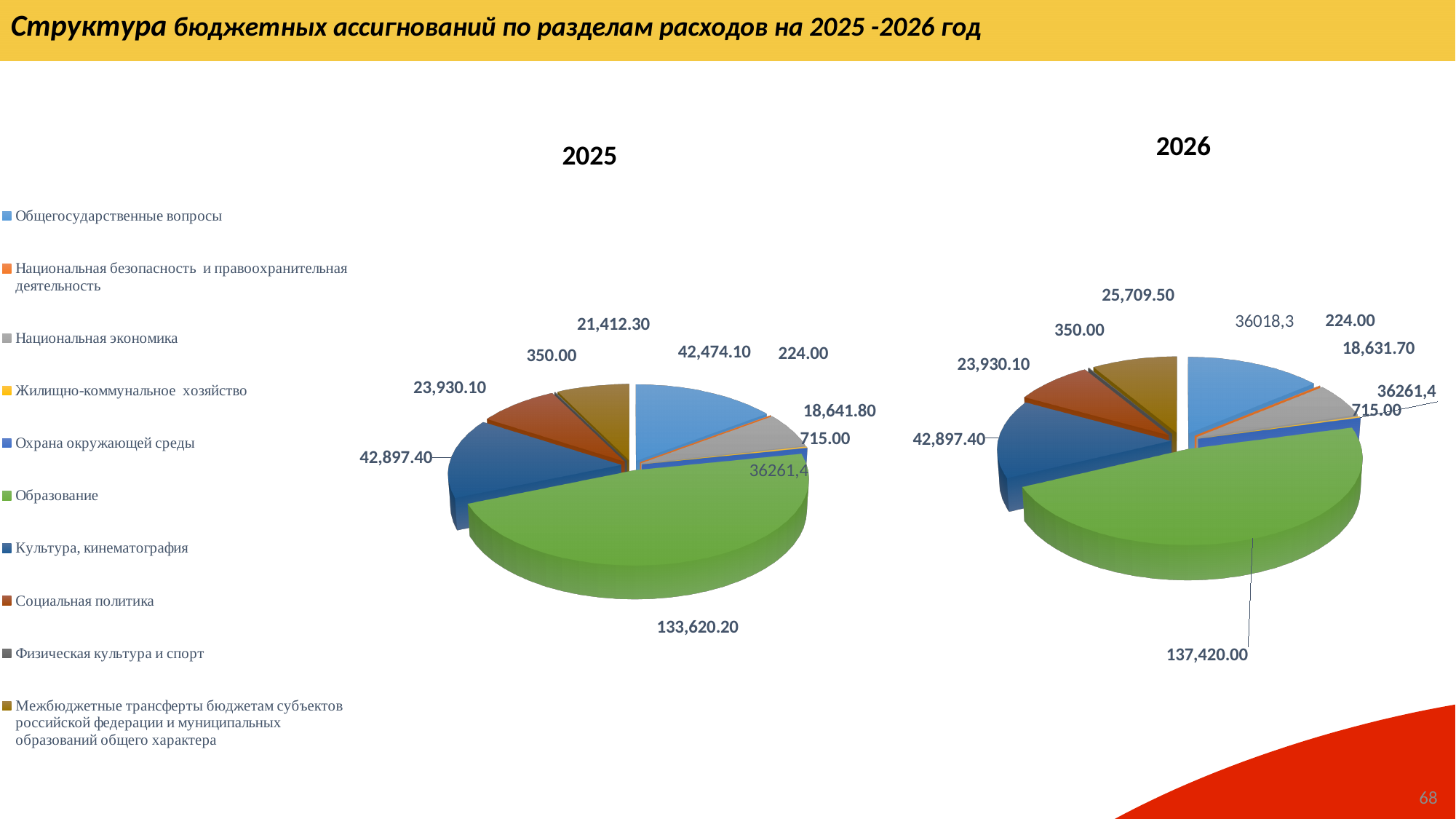
Is the value for Образование larger in the 2025 chart or the 2026 chart? 2026 How many categories does the legend list? 10 What kind of chart is used for the 2025 data? pie chart What is the difference between the Образование value in the 2026 chart and in the 2025 chart? 3,799.80 In the 2026 chart, what is the value for Образование? 137,420.00 In the 2026 chart, what is the value for Межбюджетные трансферты бюджетам субъектов российской федерации и муниципальных образований общего характера? 25,709.50 In the 2025 chart, which category has the largest slice? Образование In the 2025 chart, what is the value for Культура, кинематография? 42,897.40 In the 2025 chart, what is the value for Образование? 133,620.20 In the 2026 chart, what is the value for Социальная политика? 23,930.10 In the 2025 chart, what is the value for Межбюджетные трансферты бюджетам субъектов российской федерации и муниципальных образований общего характера? 21,412.30 In the 2025 chart, what is the value for Общегосударственные вопросы? 42,474.10